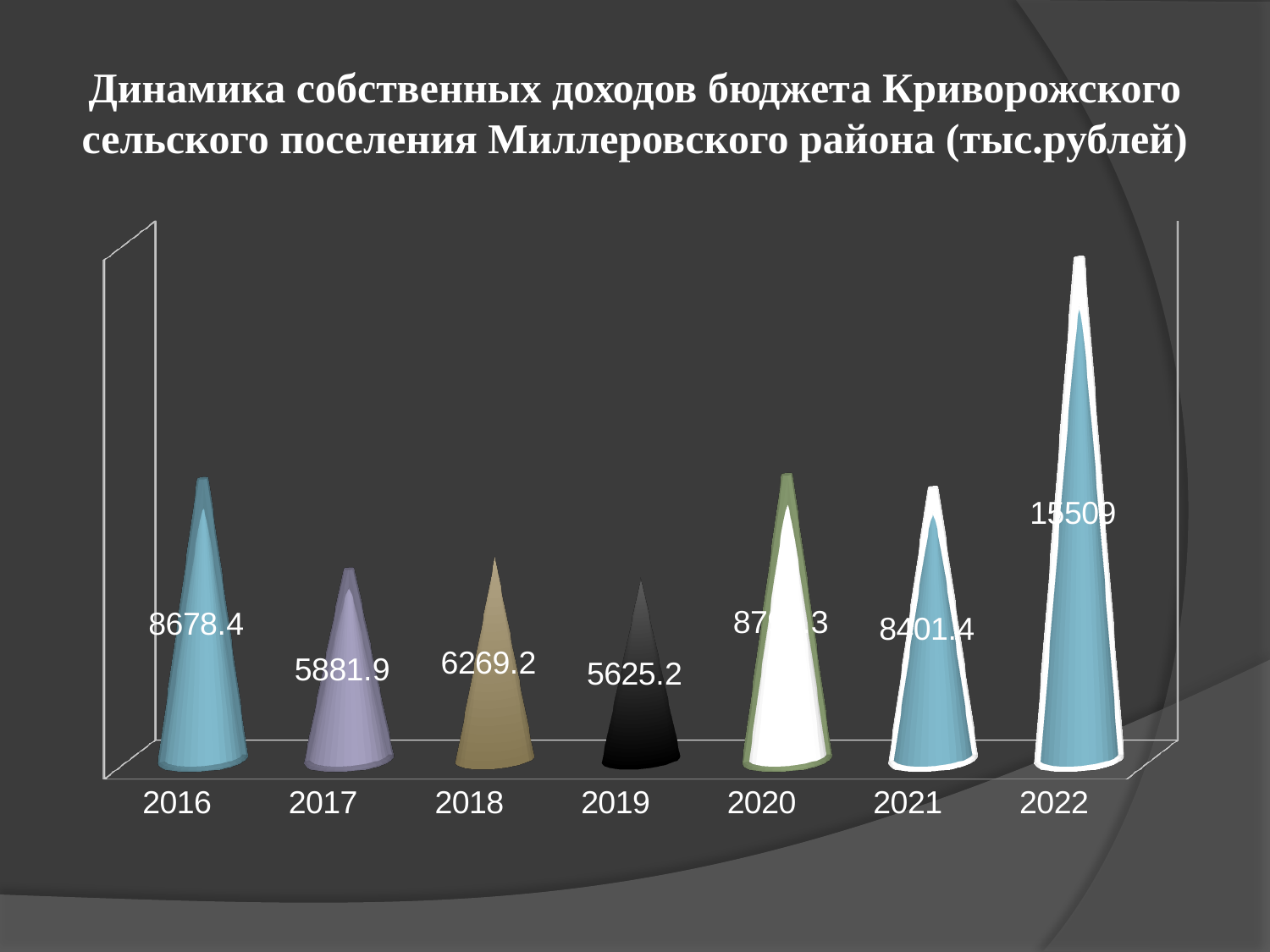
What is the value for 2019? 5625.2 What is the value for 2016? 8678.4 What is the difference between the values for 2022 and 2016? 6830.6 What unit is given in the chart title? тыс.рублей Which year has the lowest value? 2019 What is the difference between the values for 2018 and 2017? 387.3 What kind of chart is shown on the slide? bar chart Which year has the highest value? 2022 What is the value for 2022? 15509 Which is larger, the value for 2016 or the value for 2021? 2016 What is the value for 2017? 5881.9 How many years are shown on the x axis? 7